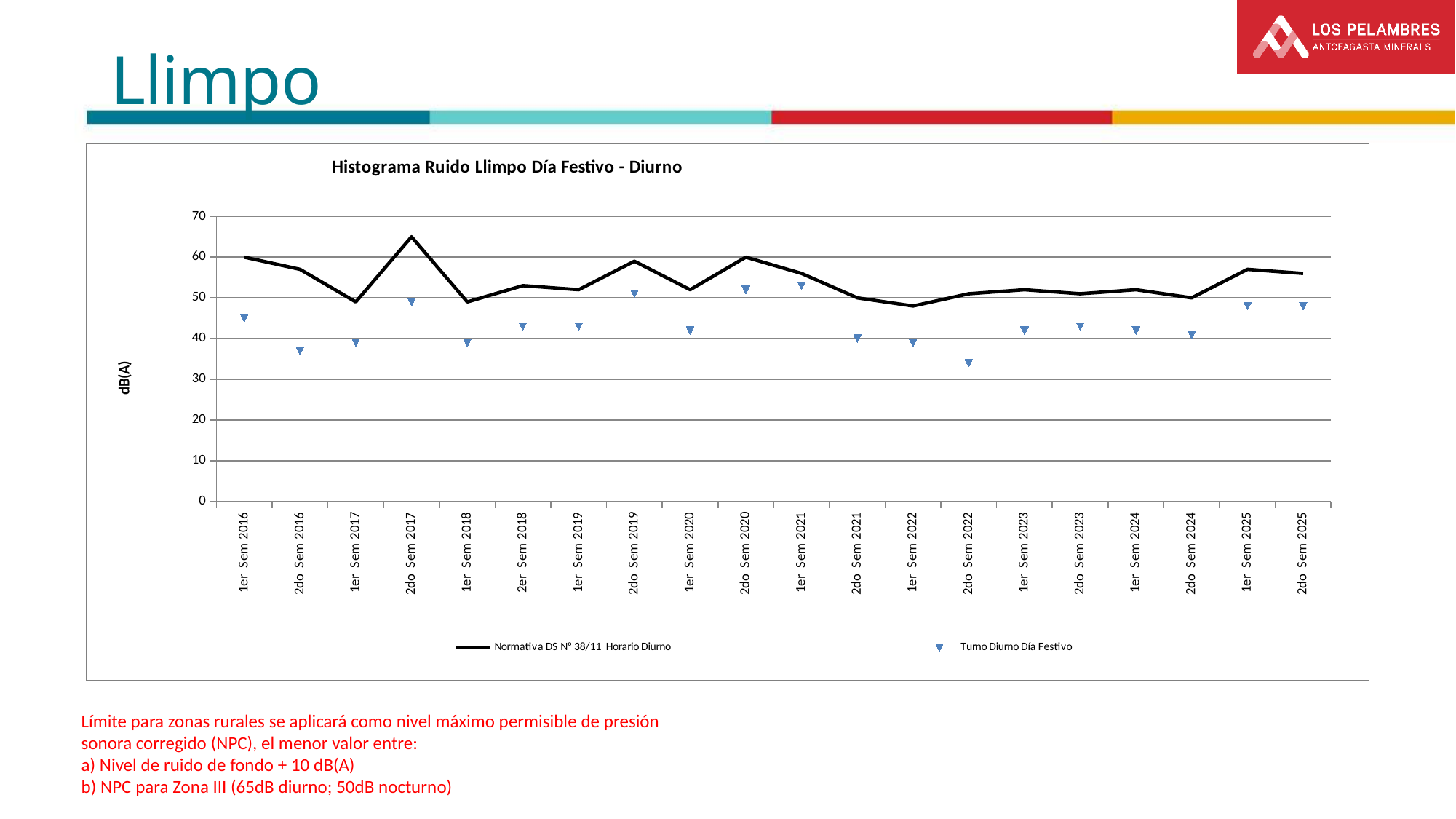
Is the Normativa DS N° 38/11 Horario Diurno value for 2do Sem 2017 greater or less than 60? greater Is the Turno Diurno Día Festivo value for 1er Sem 2021 greater or less than 50? greater Which is larger for the Normativa DS N° 38/11 Horario Diurno line: the value for 1er Sem 2016 or the value for 1er Sem 2017? 1er Sem 2016 How many series does the chart legend list? 2 In which semester is the Turno Diurno Día Festivo marker at its lowest value? 2do Sem 2022 What kind of chart is shown on the slide? line chart What label is shown on the vertical axis of the chart? dB(A) Is the Turno Diurno Día Festivo value for 2do Sem 2022 greater or less than 40? less What is the title of the chart? Histograma Ruido Llimpo Día Festivo - Diurno How many semester categories are shown along the x axis? 20 Does the Normativa DS N° 38/11 Horario Diurno line rise or fall from 2do Sem 2024 to 1er Sem 2025? rise In which semester does the Normativa DS N° 38/11 Horario Diurno line reach its highest value? 2do Sem 2017